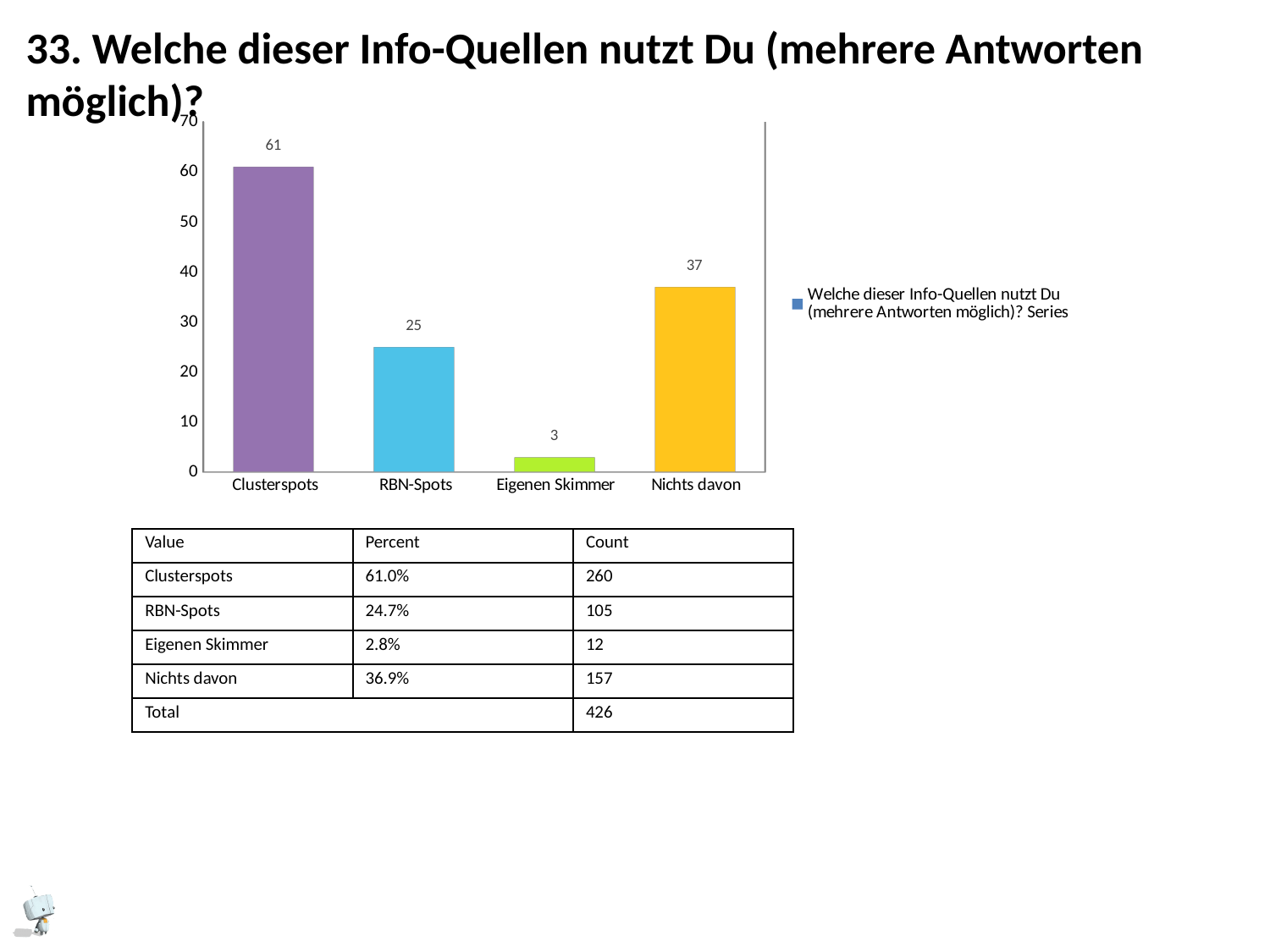
What kind of chart is shown on the slide? bar chart How many categories are shown on the x axis of the chart? 4 What is the value shown for Clusterspots in the chart? 61 What is the value shown for Eigenen Skimmer in the chart? 3 What is the value shown for RBN-Spots in the chart? 25 What colour is the bar for Clusterspots? purple Which category has the lowest value in the chart? Eigenen Skimmer Which category has the highest value in the chart? Clusterspots Is the value for Nichts davon greater or less than 30? greater What is the difference between the values for Clusterspots and Nichts davon? 24 Which is larger, the value for RBN-Spots or the value for Nichts davon? Nichts davon What is the value shown for Nichts davon in the chart? 37